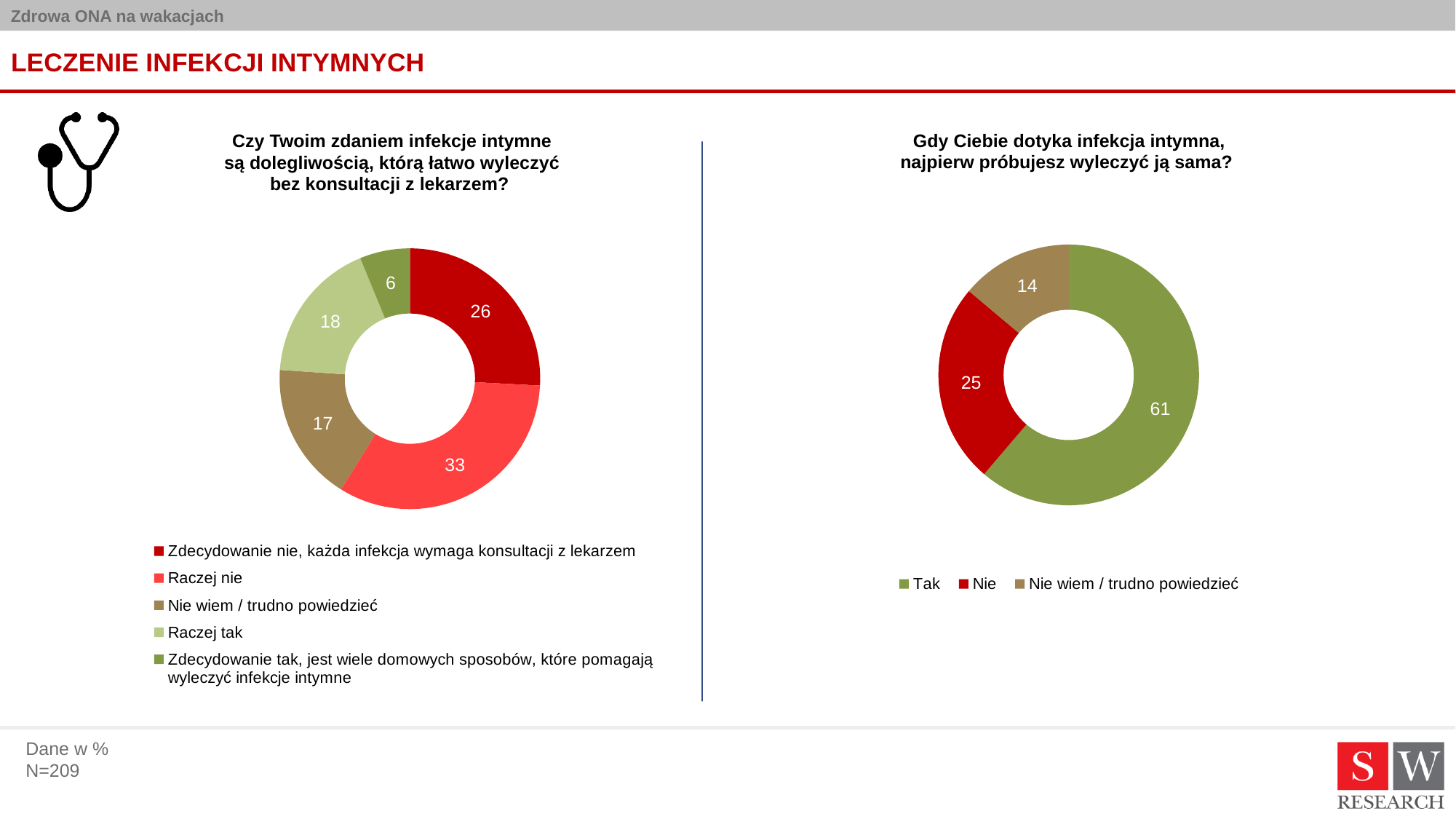
In the right chart ("Gdy Ciebie dotyka infekcja intymna, najpierw próbujesz wyleczyć ją sama?"), what is the value for "Tak"? 61 In the left chart, what is the difference between "Raczej tak" and "Nie wiem / trudno powiedzieć"? 1 In the left chart, which category has the highest value? Raczej nie In the left chart, what is the value for "Zdecydowanie nie, każda infekcja wymaga konsultacji z lekarzem"? 26 In the left chart, which category has the lowest value? Zdecydowanie tak, jest wiele domowych sposobów, które pomagają wyleczyć infekcje intymne In the right chart, what is the value for "Nie wiem / trudno powiedzieć"? 14 How many categories does the left chart show? 5 In the right chart, which is larger: "Nie" or "Nie wiem / trudno powiedzieć"? Nie In the right chart, what is the difference between "Tak" and "Nie"? 36 How many entries does the legend of the right chart list? 3 What type of chart is the right chart? Doughnut chart In the left chart ("Czy Twoim zdaniem infekcje intymne są dolegliwością, którą łatwo wyleczyć bez konsultacji z lekarzem?"), what is the value for "Raczej nie"? 33